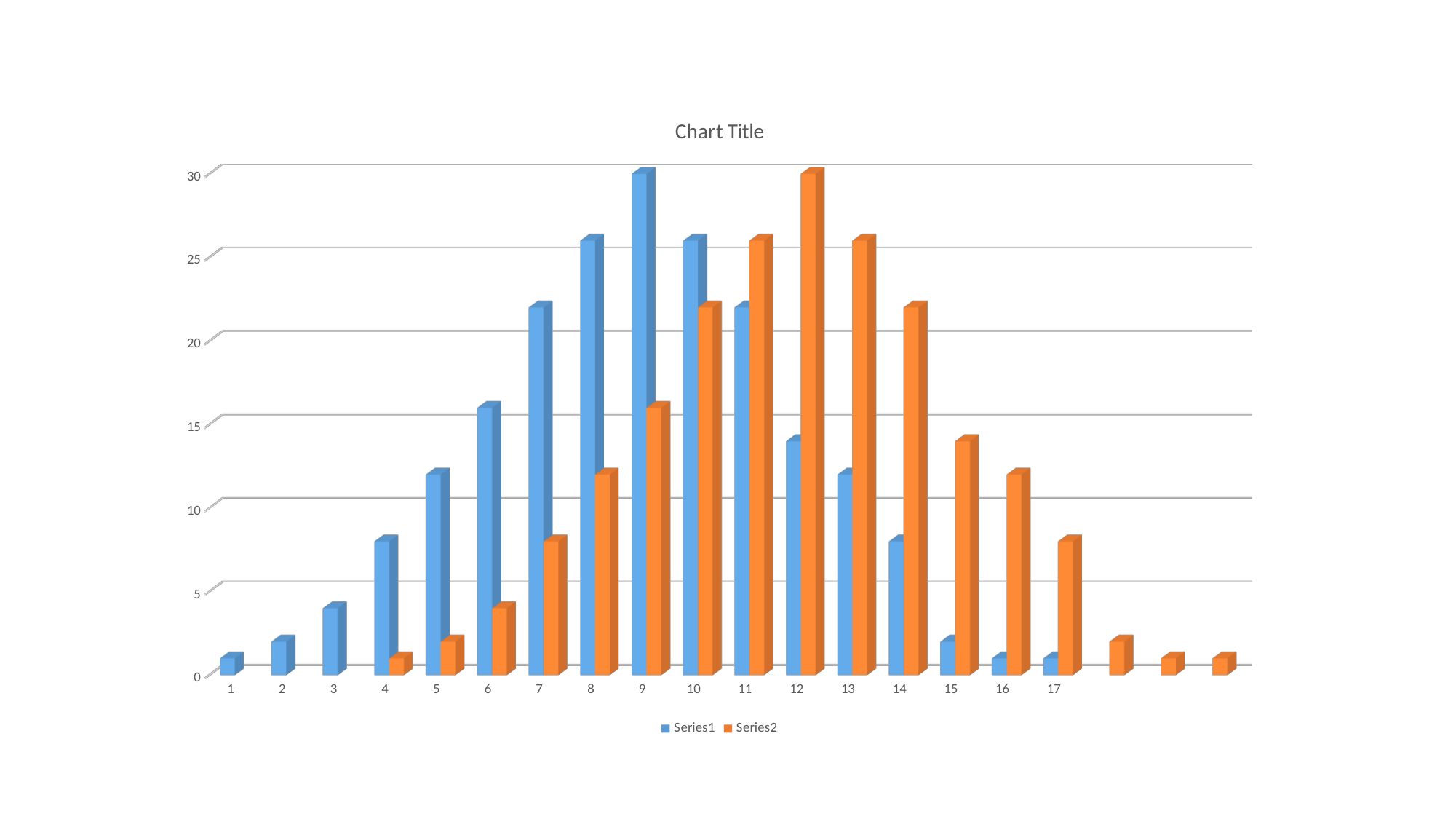
Do the Series1 values rise or fall from category 9 to category 17? Fall What is the value of Series2 at category 12? 30 Is the value for Series2 at category 6 greater or less than 5? less What is the value of Series1 at category 9? 30 At category 13, which series has the larger value, Series1 or Series2? Series2 Is the value for Series1 at category 7 greater or less than 20? greater At category 7, which series has the larger value, Series1 or Series2? Series1 Is the value for Series2 at category 16 greater or less than 10? greater How many series does the legend list? 2 At which category does Series2 reach its highest value? 12 What kind of chart is shown on the slide? Bar chart At which category does Series1 reach its highest value? 9